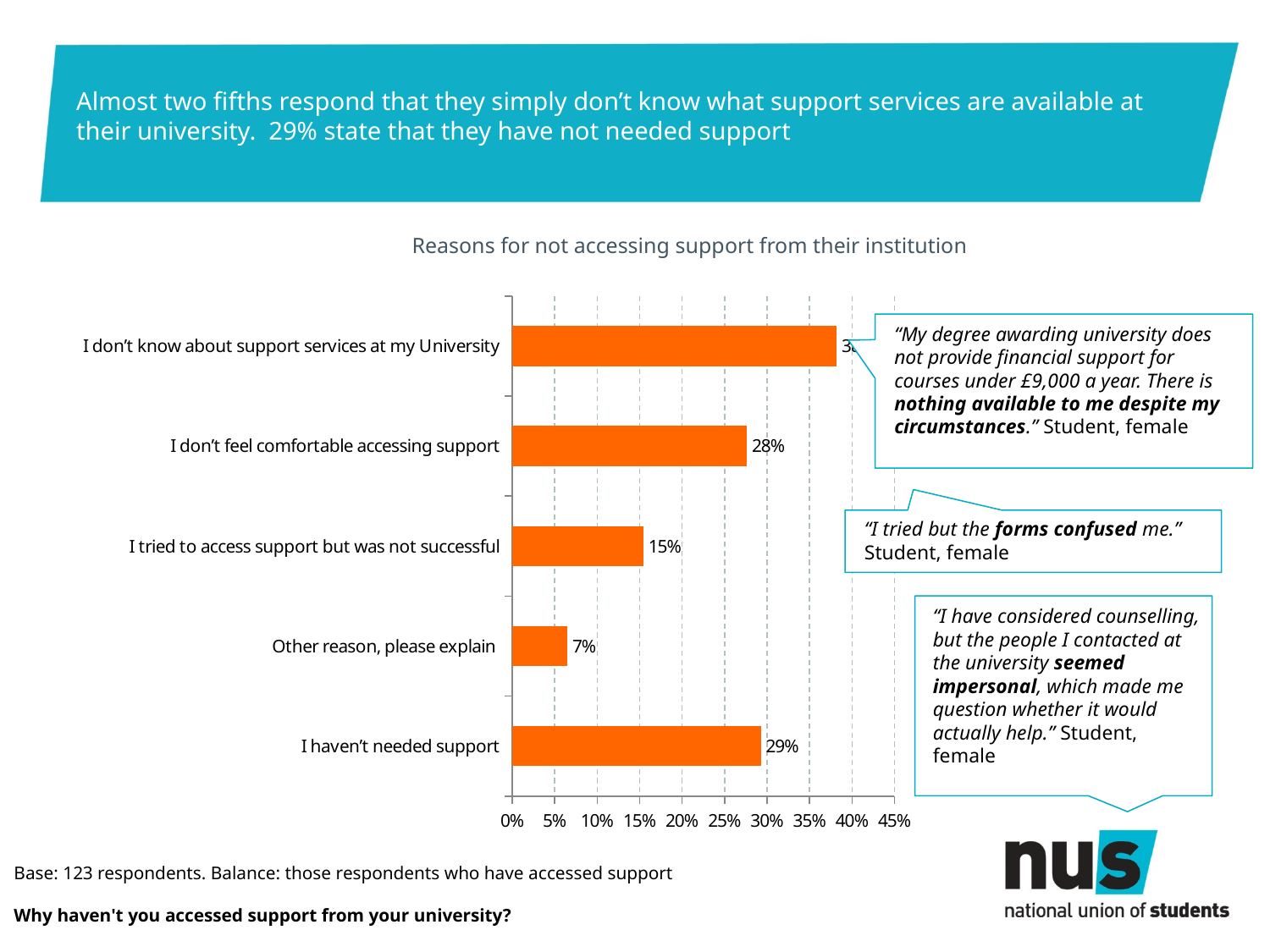
How many reasons (categories) are plotted in the chart? 5 Which is larger: the value for "I haven't needed support" or the value for "Other reason, please explain"? I haven't needed support What percentage of respondents said "I haven't needed support"? 29% Which reason has the highest value in the chart? I don't know about support services at my University What percentage of respondents said "I don't feel comfortable accessing support"? 28% Which reason has the lowest value in the chart? Other reason, please explain What is the difference between "I don't feel comfortable accessing support" and "I tried to access support but was not successful"? 13% What is the value for "I tried to access support but was not successful"? 15% What is the title of the chart? Reasons for not accessing support from their institution Is the value for "I don't know about support services at my University" greater or less than 35%? greater What is the value for "Other reason, please explain"? 7% What kind of chart is shown on the slide? bar chart